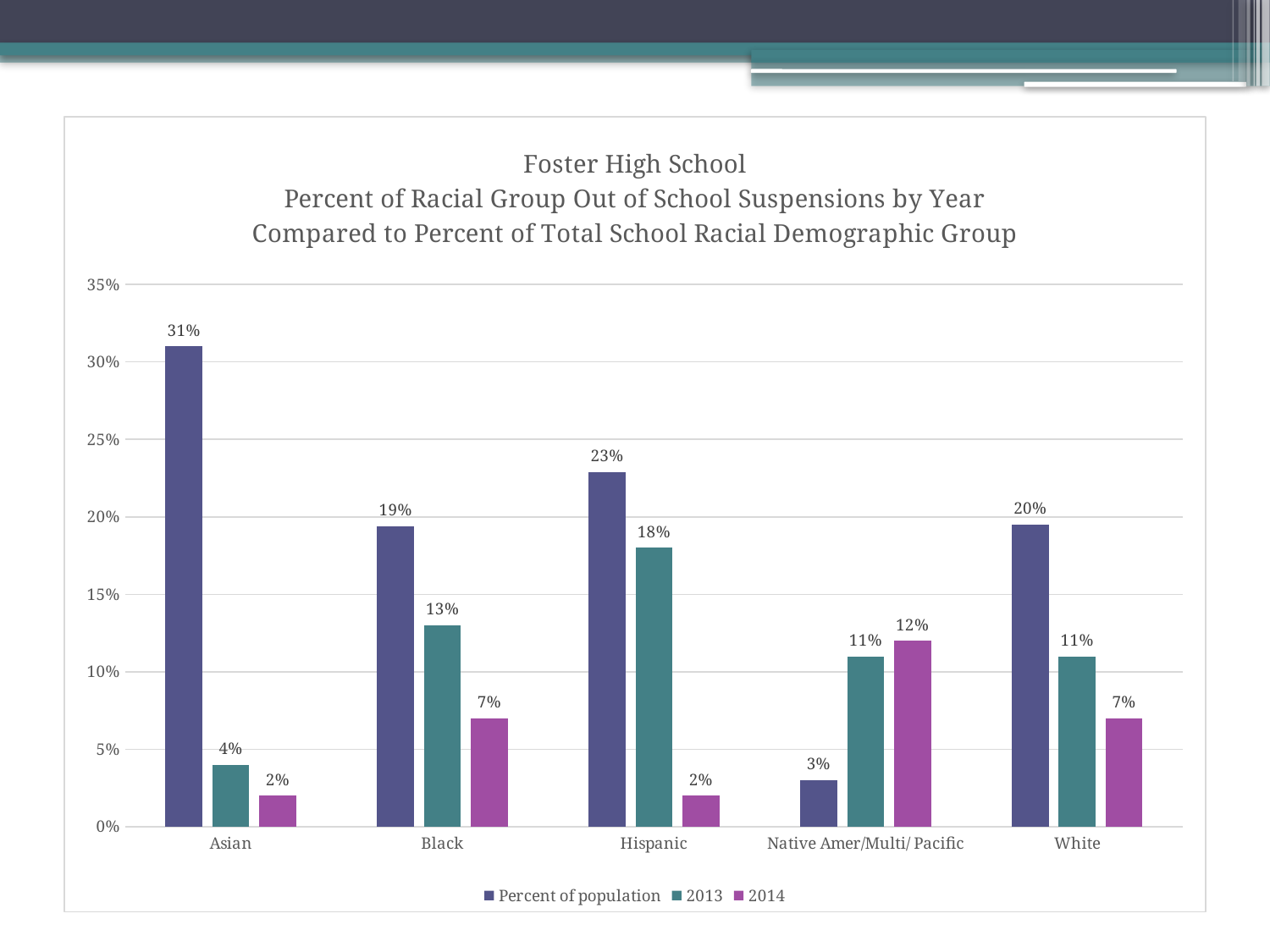
What is the 2013 value for Hispanic? 18% Which is larger for Black: the 2013 value or the 2014 value? 2013 Which category has the lowest 2013 value? Asian How many racial group categories are shown on the x axis? 5 What kind of chart is shown on the slide? Bar chart What is the 2014 value for Native Amer/Multi/ Pacific? 12% What is the Percent of population value for Asian? 31% Is the Percent of population value for Hispanic greater or less than 20%? greater Which series is shown in purple/magenta in the legend? 2014 How many series does the legend list? 3 What is the difference between the Percent of population and the 2014 value for Asian? 29% Which category has the highest Percent of population value? Asian